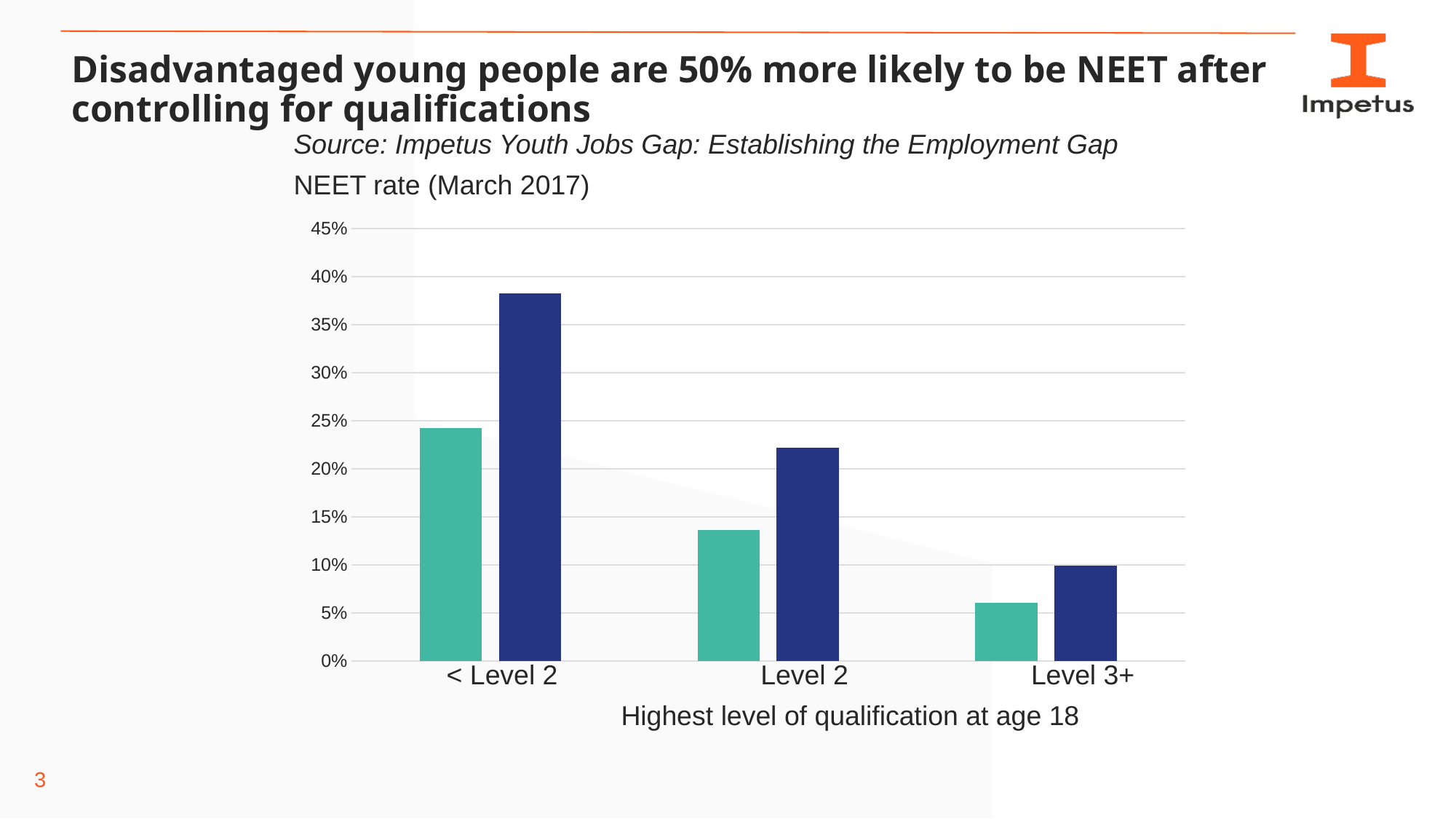
Is the value of the teal bar for < Level 2 greater or less than 20%? greater Do the NEET rates rise or fall as the highest level of qualification increases from < Level 2 to Level 3+? fall Is the value of the dark blue bar for < Level 2 greater or less than 35%? greater For Level 2, which bar is larger, the teal bar or the dark blue bar? the dark blue bar Is the value of the dark blue bar for Level 2 greater or less than 25%? less What is the title of the chart? NEET rate (March 2017) How many bars are plotted for each qualification-level category? 2 What kind of chart is shown on the slide? bar chart Which category has the highest dark blue bar? < Level 2 Which category has the lowest teal bar? Level 3+ How many qualification-level categories are shown on the x axis? 3